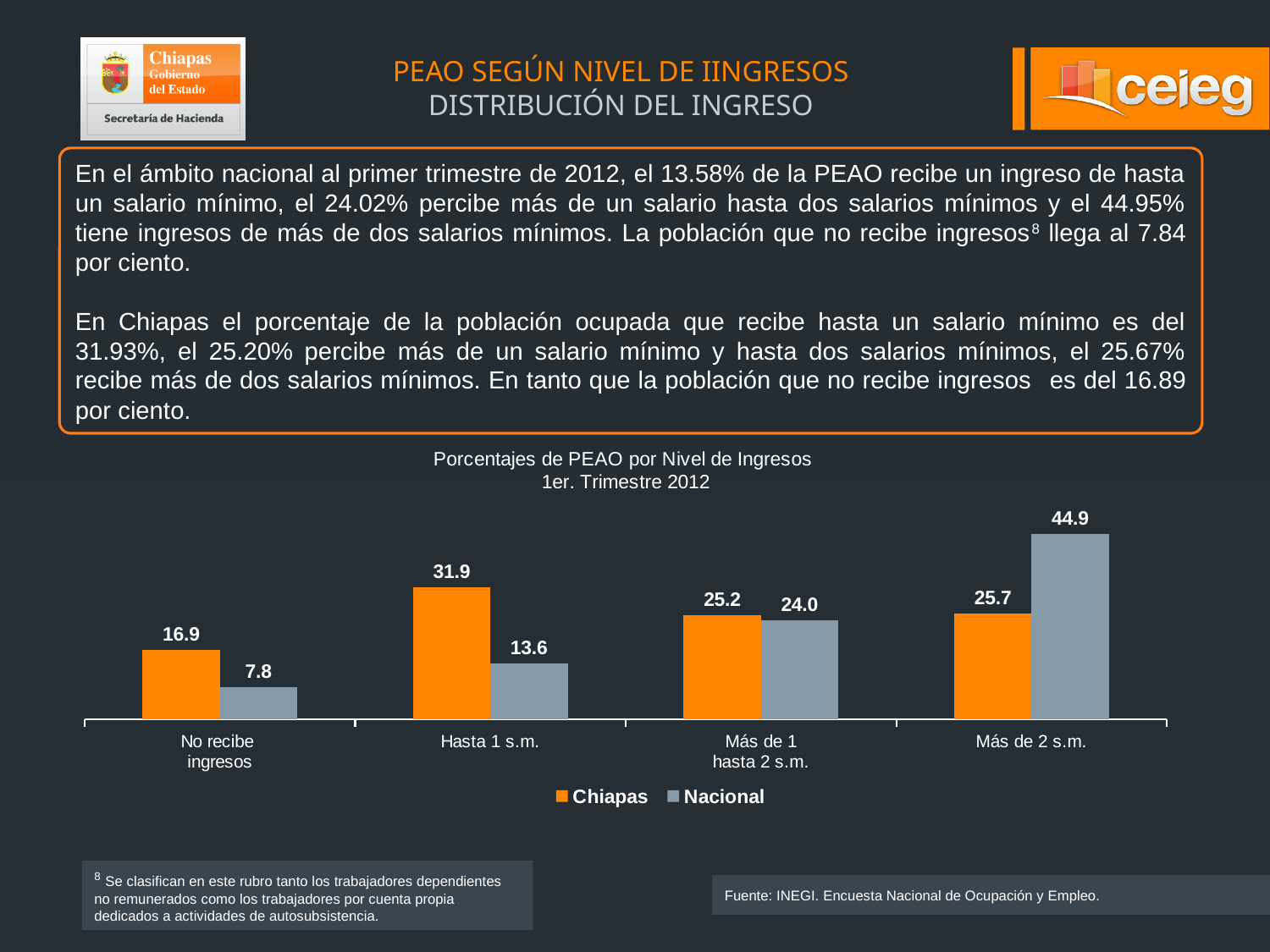
What is the difference between the Nacional and Chiapas values for 'Más de 2 s.m.'? 19.2 What kind of chart is shown on the slide? Bar chart What is the Chiapas value for 'Hasta 1 s.m.'? 31.9 What is the Nacional value for 'No recibe ingresos'? 7.8 How many series does the legend list? 2 Which category has the lowest Nacional value? No recibe ingresos How many income categories are shown on the x axis? 4 Which category has the highest Chiapas value? Hasta 1 s.m. What is the title of the chart? Porcentajes de PEAO por Nivel de Ingresos 1er. Trimestre 2012 What is the difference between the Chiapas and Nacional values for 'Hasta 1 s.m.'? 18.3 For 'No recibe ingresos', which series has the larger value, Chiapas or Nacional? Chiapas What is the Nacional value for 'Más de 2 s.m.'? 44.9